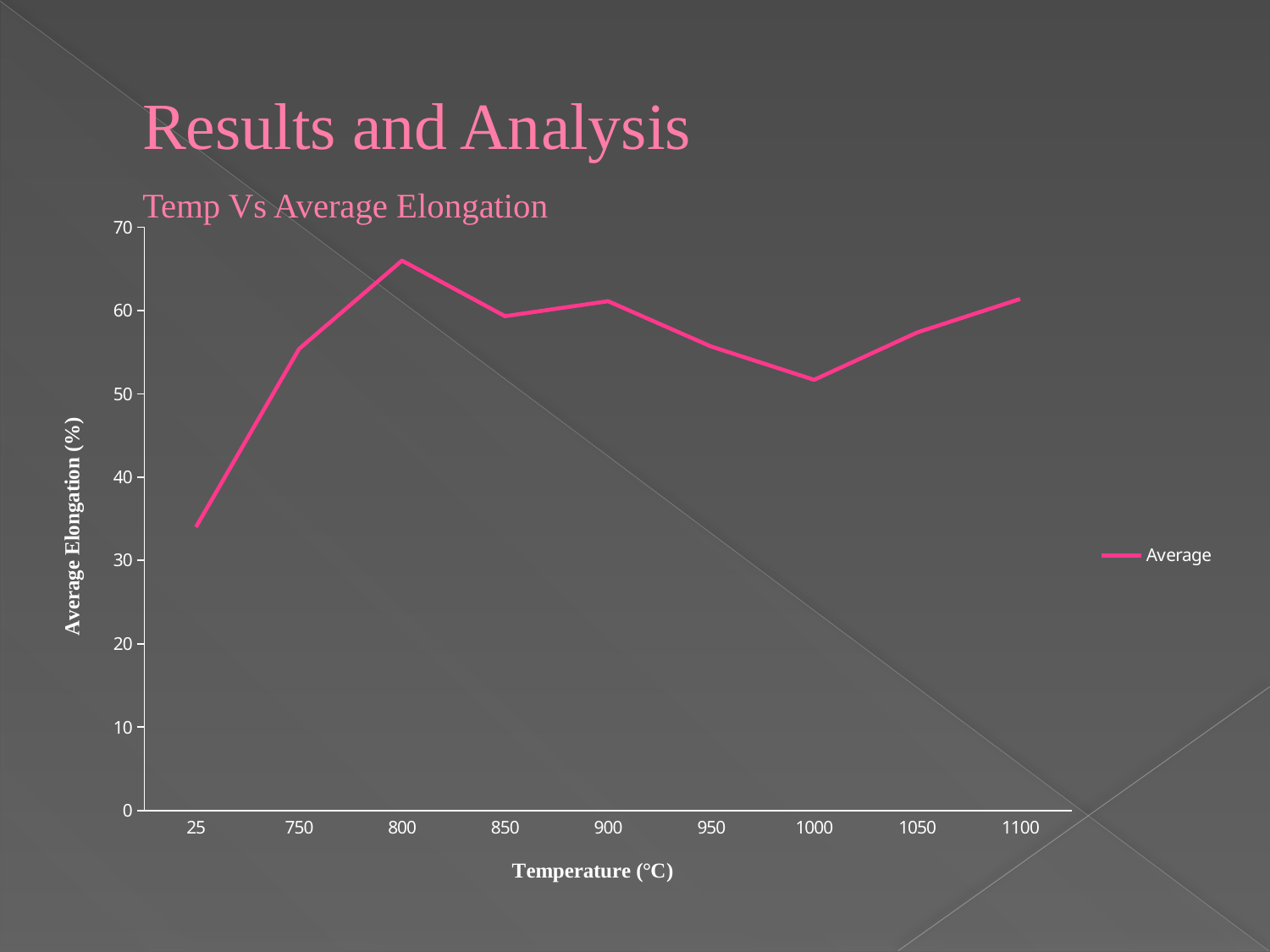
At which temperature is the average elongation lowest? 25 Which has the higher average elongation, 800 °C or 1000 °C? 800 °C What is the title of the chart? Temp Vs Average Elongation How many series does the legend list? 1 Is the average elongation at 1000 °C greater or less than 60? less What is the label of the y axis? Average Elongation (%) How many temperature points are plotted on the x axis? 9 What kind of chart is shown on the slide? line chart Is the average elongation at 25 °C greater or less than 40? less Does the average elongation rise or fall between 800 °C and 1000 °C? fall Is the average elongation at 800 °C greater or less than 60? greater At which temperature is the average elongation highest? 800